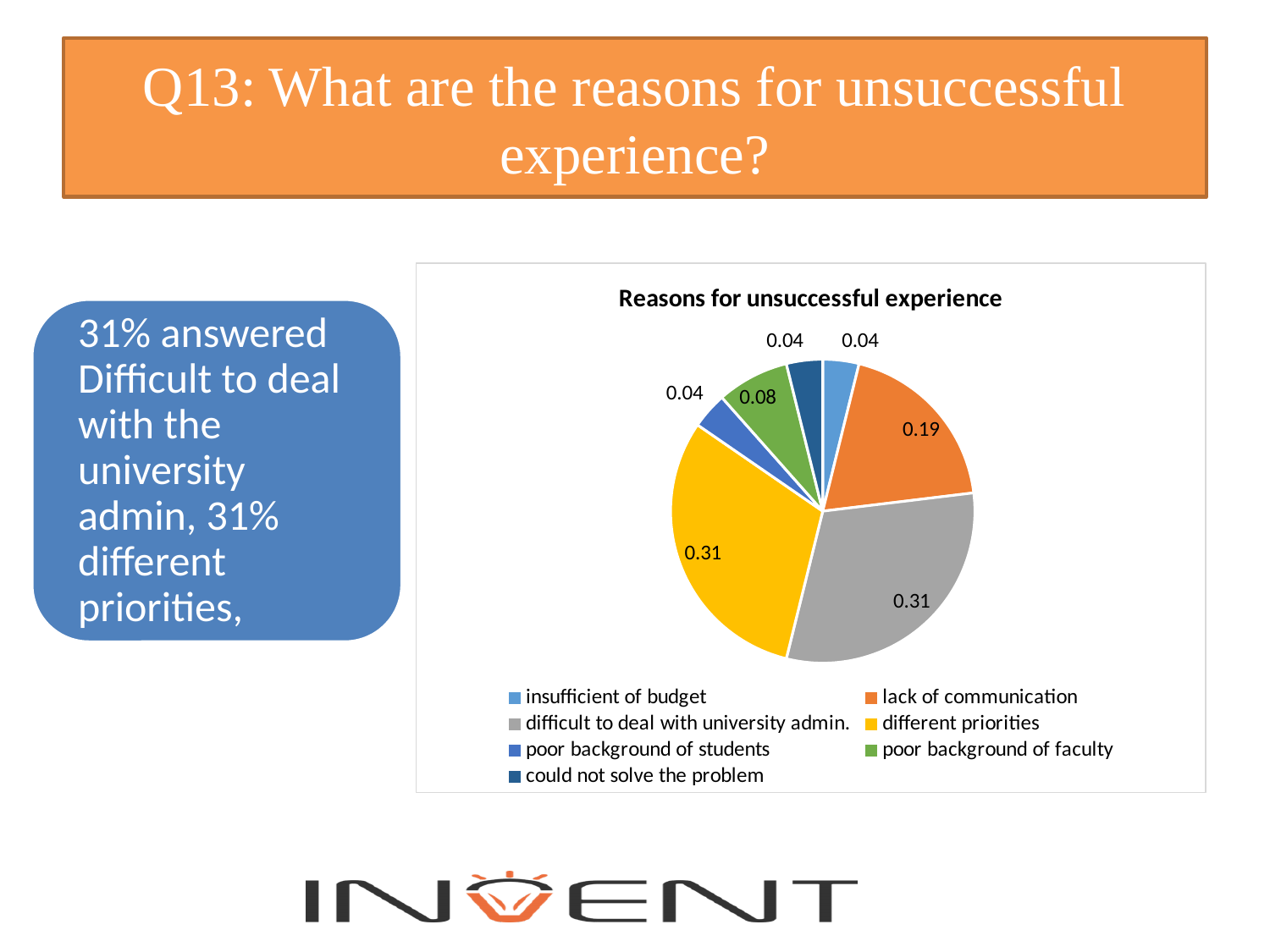
What kind of chart is shown on the slide? pie chart How many categories does the pie chart have? 7 What is the value shown for 'lack of communication'? 0.19 What is the value shown for 'poor background of faculty'? 0.08 What is the value shown for 'different priorities'? 0.31 What is the title of the chart? Reasons for unsuccessful experience Which colour represents 'different priorities' in the legend? yellow Which is larger, the slice for 'lack of communication' or the slice for 'poor background of faculty'? lack of communication What is the value shown for 'difficult to deal with university admin.'? 0.31 What is the value shown for 'insufficient of budget'? 0.04 What is the difference between the values for 'lack of communication' and 'poor background of faculty'? 0.11 What is the difference between the values for 'different priorities' and 'lack of communication'? 0.12